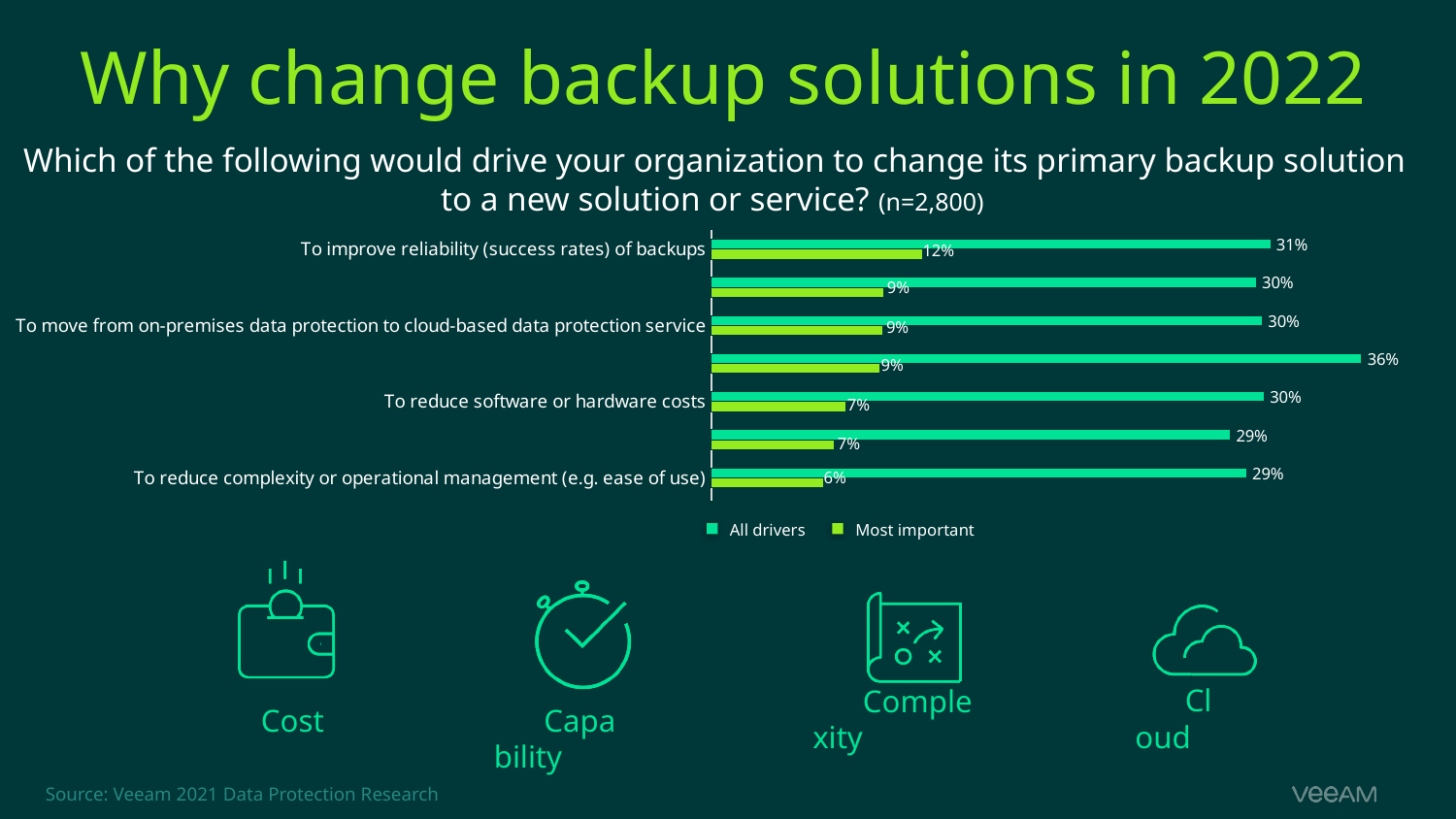
What kind of chart is shown on the slide? Bar chart What is the 'All drivers' value for 'To improve reliability (success rates) of backups'? 31% What is the difference between the 'All drivers' and 'Most important' values for 'To improve reliability (success rates) of backups'? 19% Which labelled category has the highest 'Most important' value? To improve reliability (success rates) of backups What is the 'Most important' value for 'To improve reliability (success rates) of backups'? 12% How many categories (pairs of bars) are plotted in the chart? 7 What is the 'Most important' value for 'To move from on-premises data protection to cloud-based data protection service'? 9% Which is larger for 'To reduce software or hardware costs': the 'All drivers' value or the 'Most important' value? All drivers What is the 'Most important' value for 'To reduce complexity or operational management (e.g. ease of use)'? 6% How many series does the legend list? 2 What is the highest value shown in the 'All drivers' series? 36% What is the 'All drivers' value for 'To reduce software or hardware costs'? 30%